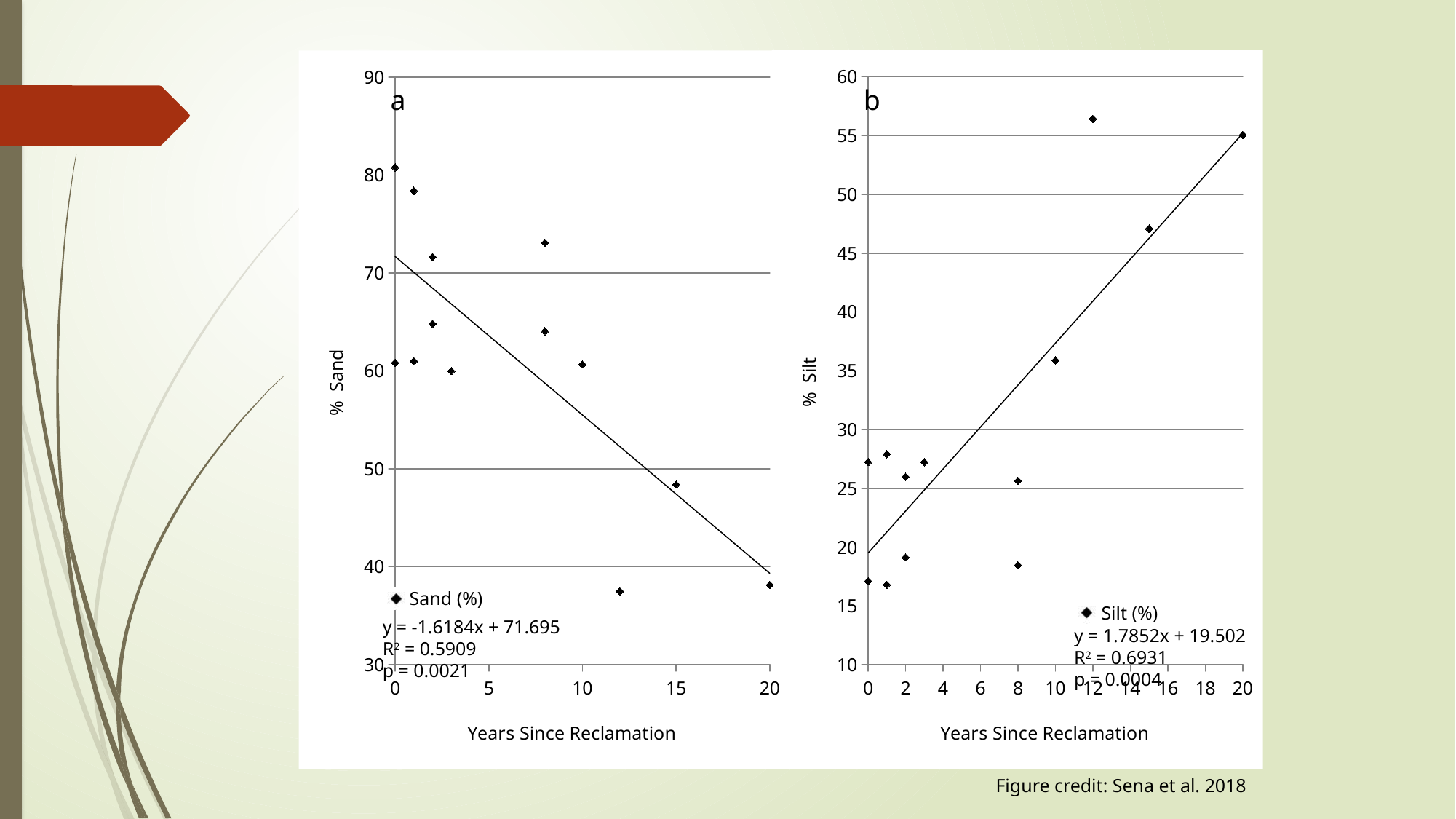
In chart a (% Sand), is the value at 15 years since reclamation greater or less than 50? less In chart b (% Silt), is the highest plotted point at 12 years or at 20 years since reclamation? 12 years How many series does the legend of chart a list? 1 In chart b (% Silt), is the value at 12 years since reclamation greater or less than 55? greater What trendline equation is shown in chart b (% Silt)? y = 1.7852x + 19.502 What is the legend entry shown in chart a? Sand (%) In chart a (% Sand), is the value at 12 years since reclamation greater or less than 40? less In chart b (% Silt), do the values generally rise or fall as Years Since Reclamation increases? rise How many series does the legend of chart b list? 1 In chart a (% Sand), do the values generally rise or fall as Years Since Reclamation increases? fall What kind of chart is chart a (% Sand)? scatter chart